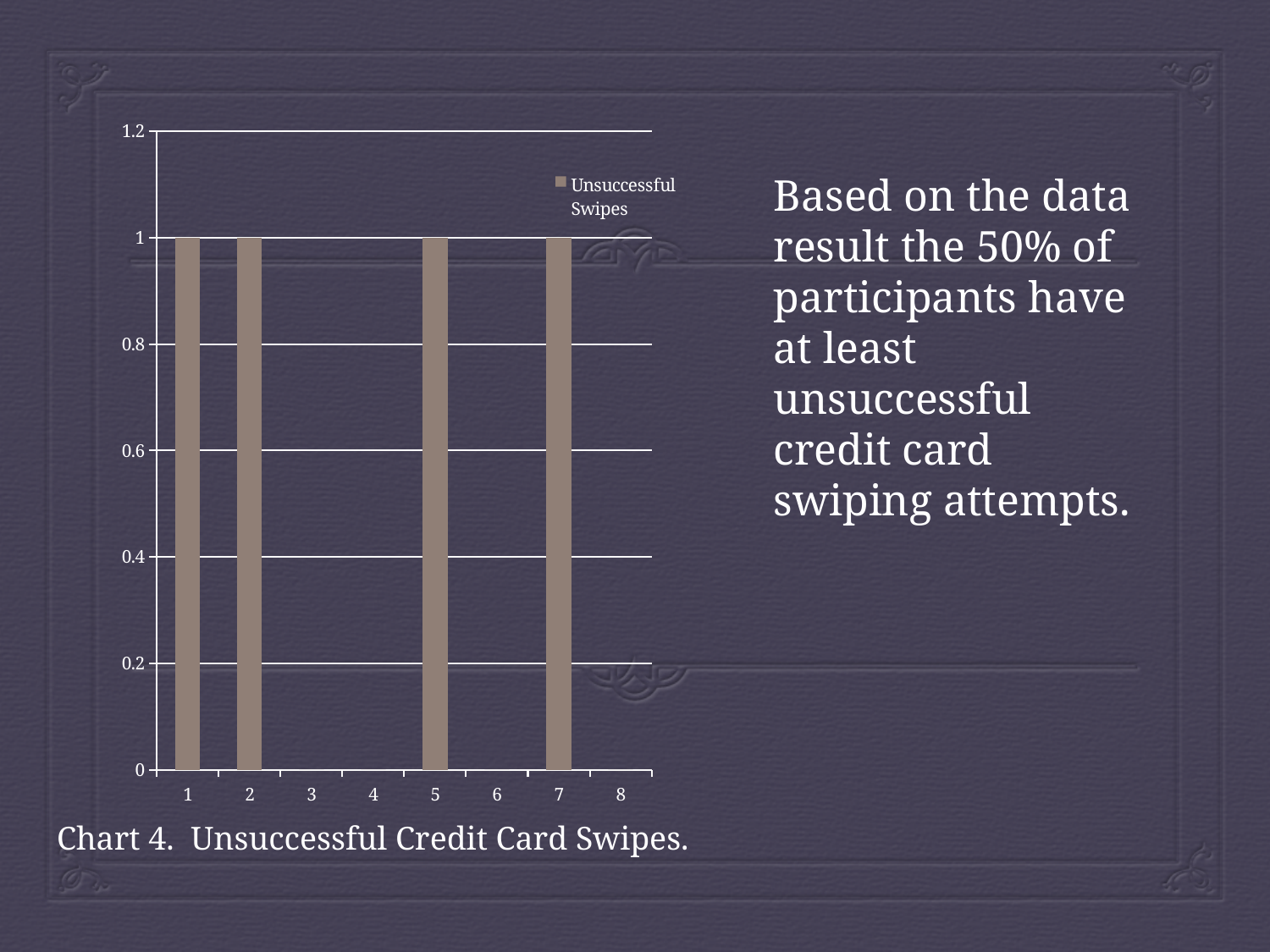
How many series does the chart's legend list? 1 Is the value for category 1 greater or less than 0.8? greater Which is larger, the value for category 2 or the value for category 4? category 2 What kind of chart is shown on the slide? bar chart What is the value of Unsuccessful Swipes for category 3? 0 What series name is shown in the chart's legend? Unsuccessful Swipes What is the caption given for the chart on the slide? Chart 4. Unsuccessful Credit Card Swipes. What is the value of Unsuccessful Swipes for category 1? 1 What is the value of Unsuccessful Swipes for category 7? 1 How many categories are shown on the x axis of the chart? 8 How many categories have a bar with a value of 1? 4 What is the difference between the value for category 5 and the value for category 6? 1